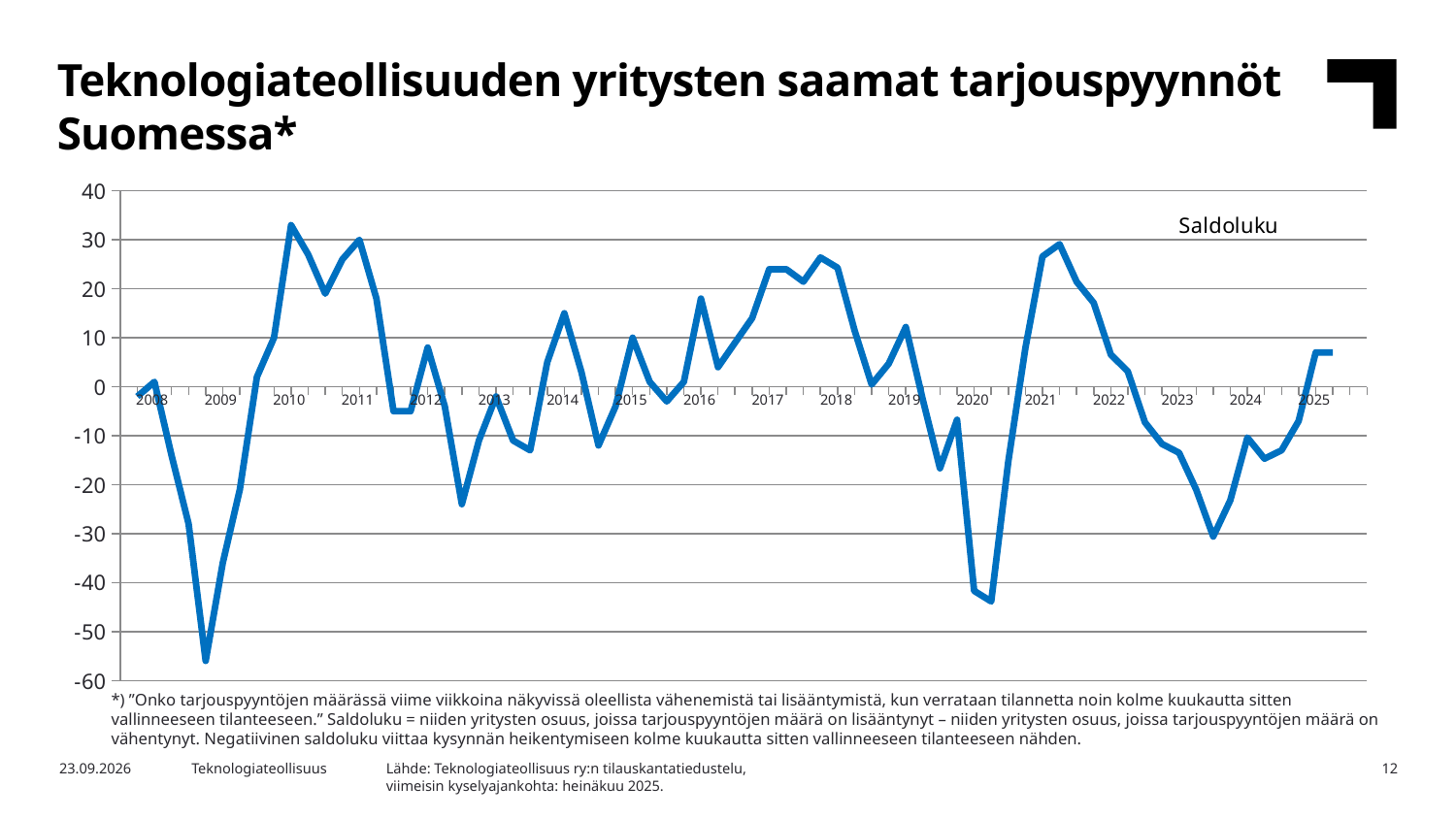
Is the peak value of the line in 2021 greater or less than 20? greater Is the peak value of the line in 2010 greater or less than 30? greater Is the last plotted value of the line in 2025 greater or less than 0? greater What kind of chart is shown on the slide? line chart Does the line rise or fall between its low point in 2023 and the end of the series in 2025? rise Does the line rise or fall from its peak in 2021 to its low point in 2023? fall In which year does the line reach its lowest point? 2009